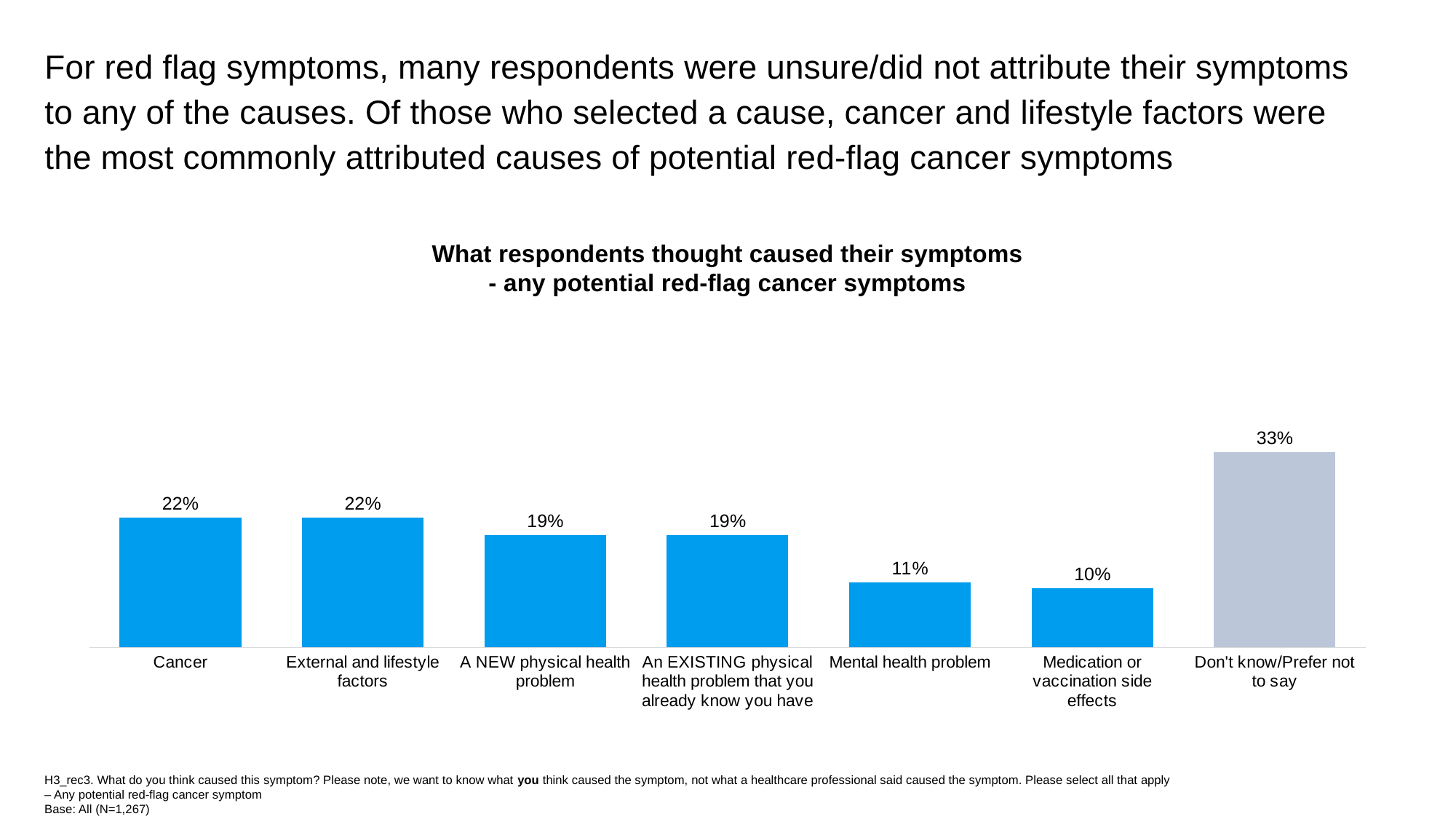
Which category has the highest value? Don't know/Prefer not to say What is the difference between A NEW physical health problem and Mental health problem? 8 percentage points What is the value for Medication or vaccination side effects? 10% What is the difference between Don't know/Prefer not to say and Cancer? 11 percentage points Which category has the lowest value? Medication or vaccination side effects How many categories are shown in the chart? 7 Which is larger: External and lifestyle factors or An EXISTING physical health problem that you already know you have? External and lifestyle factors What type of chart is shown on the slide? Bar chart Which bar is shown in a different colour (grey) from the others? Don't know/Prefer not to say What is the value for Mental health problem? 11% What is the value for Don't know/Prefer not to say? 33% What percentage of respondents attributed their symptoms to Cancer? 22%